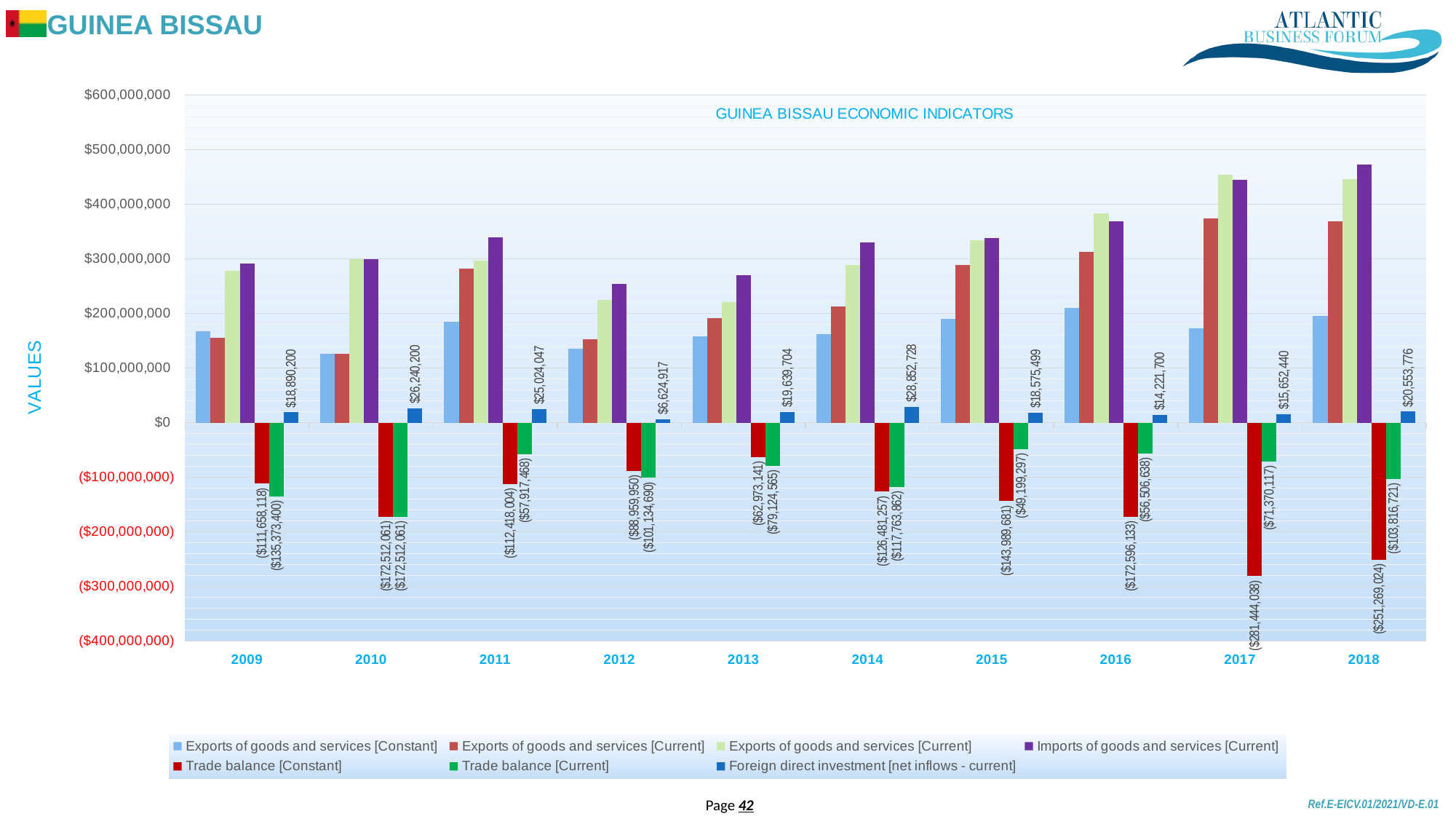
What is the value of Trade balance [Constant] in 2017? ($281,444,038) What is the difference between Foreign direct investment in 2014 and in 2012? $22,227,811 What is the value of Foreign direct investment [net inflows - current] in 2014? $28,852,728 In which year is Foreign direct investment [net inflows - current] the lowest? 2012 In which year is Foreign direct investment [net inflows - current] the highest? 2014 Is the value of Imports of goods and services [Current] in 2018 greater or less than $400,000,000? greater Which is larger: Foreign direct investment in 2010 or in 2011? 2010 How many series does the legend list? 7 What is the title of the chart? GUINEA BISSAU ECONOMIC INDICATORS How many years are shown on the x axis? 10 What is the value of Trade balance [Current] in 2015? ($49,199,297) What type of chart is shown on the slide? Bar chart